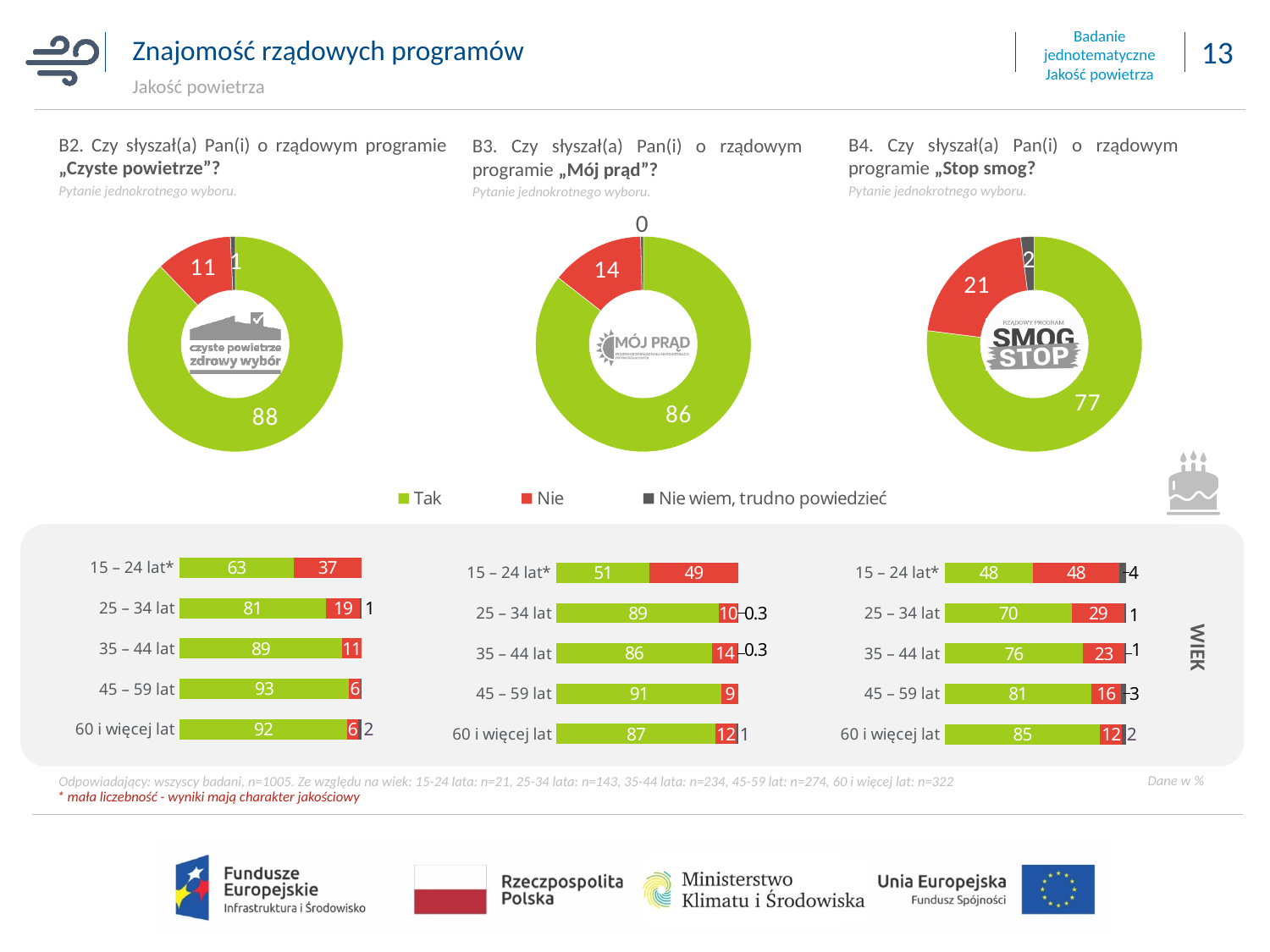
In the B3 "Mój prąd" bar chart by age, is the "Tak" value for 25 – 34 lat larger or smaller than for 60 i więcej lat? Larger In the B3 "Mój prąd" bar chart by age, which age group has the highest "Tak" value? 45 – 59 lat What kind of chart is used for the B2, B3 and B4 results by age group at the bottom of the slide? Stacked bar chart In the B4 "Stop smog?" bar chart by age, what is the "Nie" value for 25 – 34 lat? 29 How many age groups are shown in each bar chart by age? 5 In the B4 "Stop smog?" donut chart, what is the difference between the "Tak" and "Nie" values? 56 In the B2 "Czyste powietrze" donut chart, what is the value for "Tak"? 88 Across the three donut charts, which programme has the lowest "Tak" value? Stop smog How many series does the legend list? 3 In the B4 "Stop smog?" donut chart, what is the value for "Nie wiem, trudno powiedzieć"? 2 In the B3 "Mój prąd" donut chart, what is the value for "Nie"? 14 In the B2 "Czyste powietrze" bar chart by age, what is the "Tak" value for 15 – 24 lat*? 63